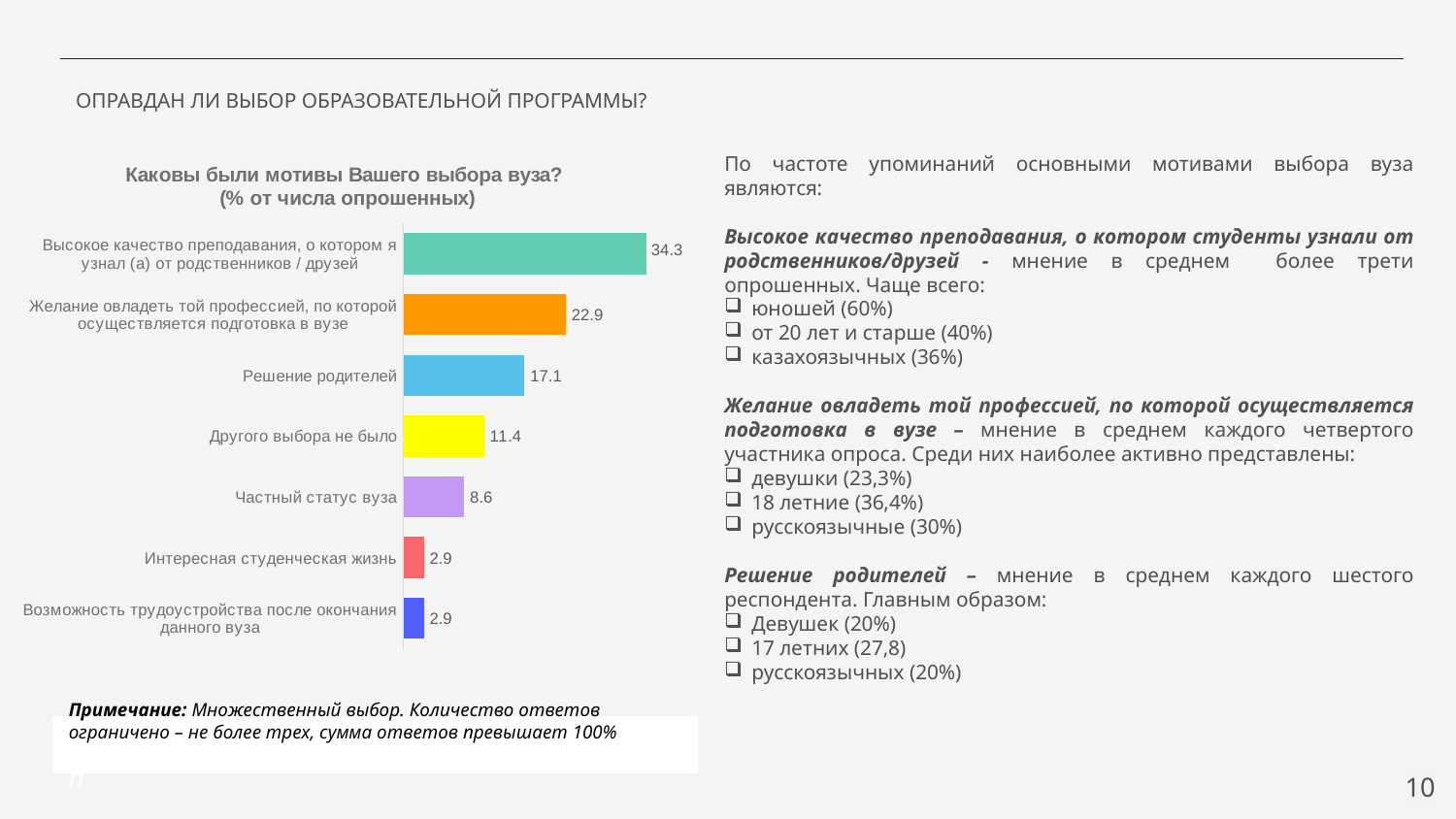
What is the title of the chart? Каковы были мотивы Вашего выбора вуза? (% от числа опрошенных) What is the lowest value shown in the chart? 2.9 What is the value for "Частный статус вуза"? 8.6 Which category has the highest value? Высокое качество преподавания, о котором я узнал (а) от родственников / друзей What type of chart is shown on the slide? Bar chart What is the difference between the values for "Высокое качество преподавания, о котором я узнал (а) от родственников / друзей" and "Желание овладеть той профессией, по которой осуществляется подготовка в вузе"? 11.4 What is the difference between the values for "Решение родителей" and "Частный статус вуза"? 8.5 What is the value for "Решение родителей"? 17.1 Which is larger: the value for "Другого выбора не было" or the value for "Частный статус вуза"? Другого выбора не было What is the value for "Другого выбора не было"? 11.4 How many categories are shown in the chart? 7 What is the value for "Желание овладеть той профессией, по которой осуществляется подготовка в вузе"? 22.9